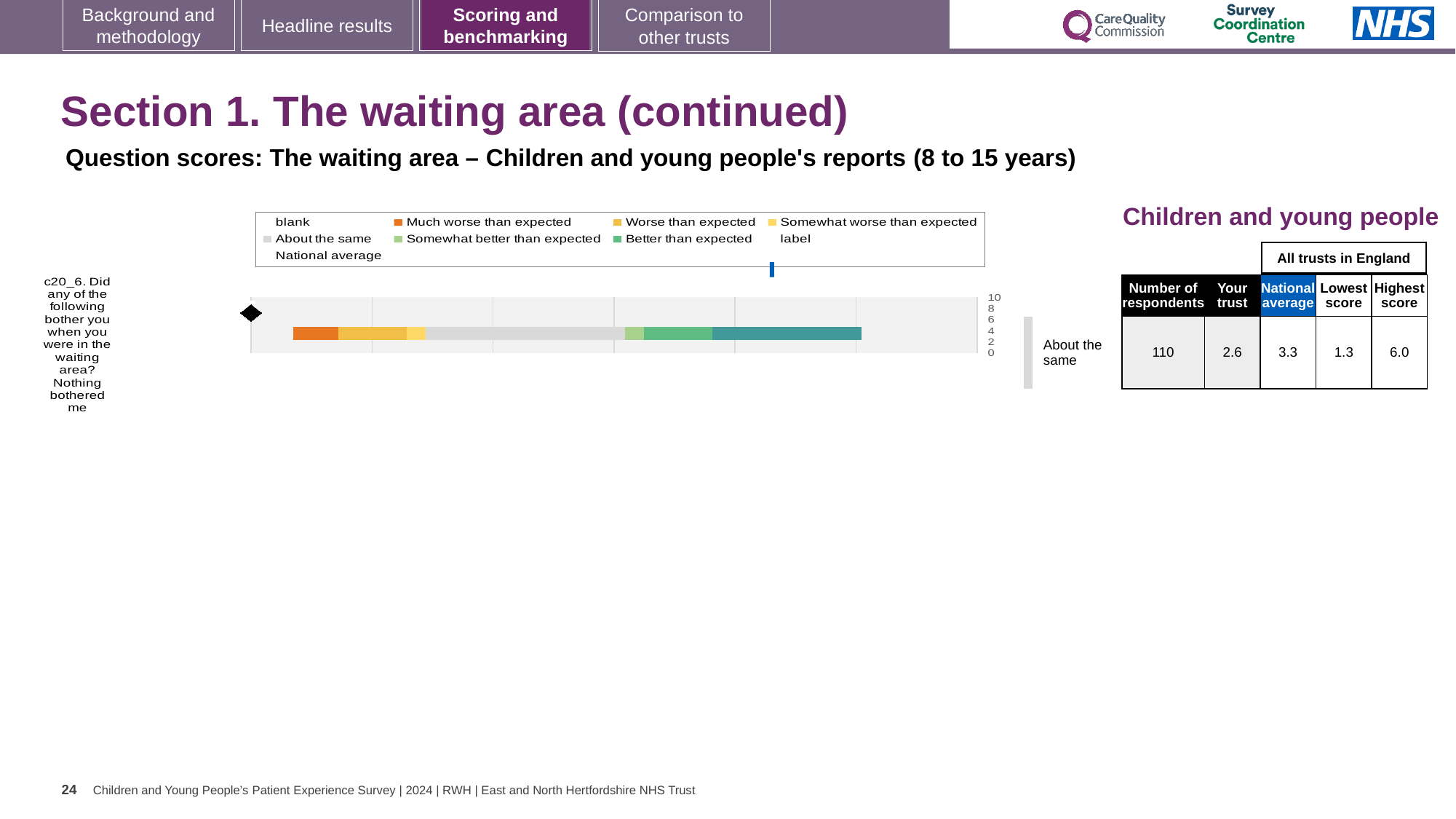
How many respondents are reported for question c20_6? 110 How many entries does the chart legend list? 9 What rating label is shown to the right of the bar for question c20_6? About the same How many question categories are plotted in the chart? 1 What is the difference between the highest score and the lowest score in the table? 4.7 Which is larger, the 'Your trust' score or the national average? National average What colour does the legend use for 'Much worse than expected'? orange In the table, what is the highest score among all trusts in England? 6.0 In the table, what is the lowest score among all trusts in England? 1.3 In the table, what is the national average score for question c20_6? 3.3 In the table, what is the 'Your trust' score for question c20_6? 2.6 What kind of chart is shown on the slide? bar chart